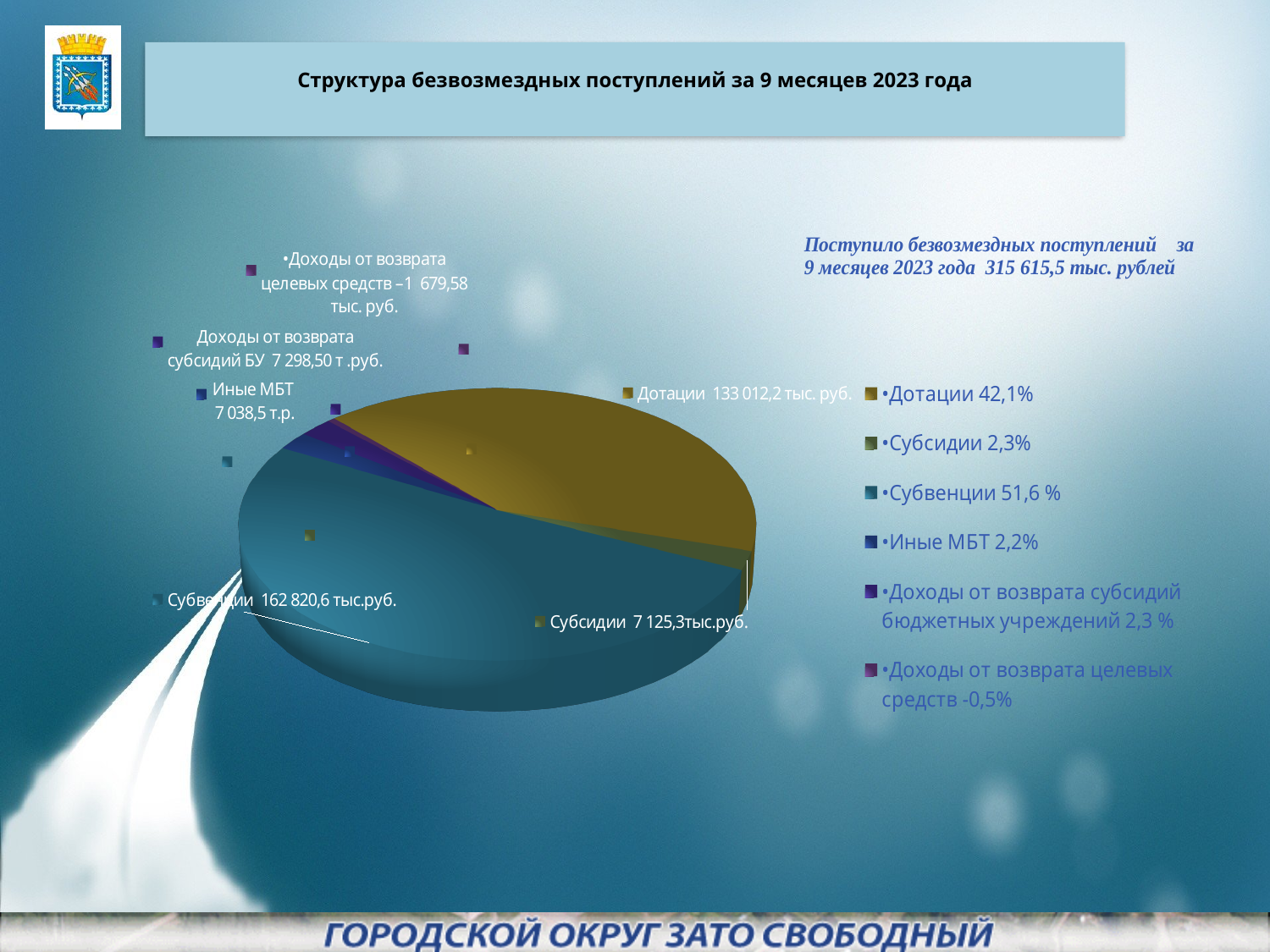
How many categories does the legend list? 6 Which category has the smallest value in the pie chart? Доходы от возврата целевых средств What share of the pie does Субвенции represent according to the legend? 51,6 % What is the value shown for Дотации? 133 012,2 тыс. руб. What is the value shown for Субсидии? 7 125,3 тыс.руб. What is the value shown for Субвенции? 162 820,6 тыс.руб. What is the value shown for Доходы от возврата целевых средств? –1 679,58 тыс. руб. Which is larger, Дотации or Субвенции? Субвенции Which category has the largest value in the pie chart? Субвенции What is the difference between the values for Субвенции and Дотации? 29 808,4 тыс. руб. What type of chart is shown on the slide? Pie chart What is the value shown for Иные МБТ? 7 038,5 т.р.